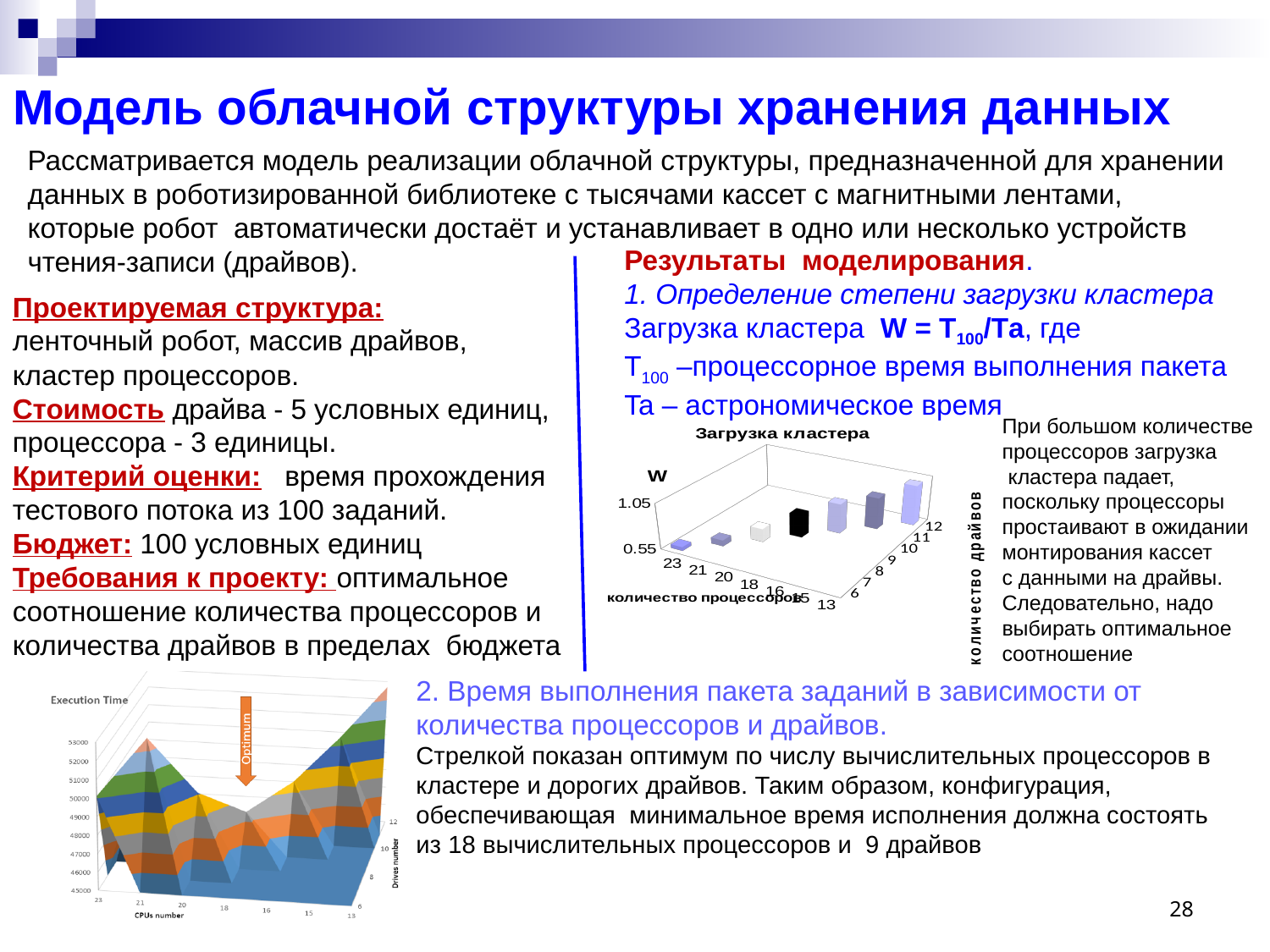
In the 'Загрузка кластера' chart, is the value for 23 processors greater or less than 1.05? less In the 'Загрузка кластера' chart, is the bar for 13 processors taller or shorter than the bar for 23 processors? taller In the 'Загрузка кластера' chart, what kind of chart is shown? bar chart In the 'Загрузка кластера' chart, as the number of processors decreases from 23 to 13 along the x axis, does W rise or fall? rise In the 'Execution Time' chart, what is the highest tick value on the vertical axis? 53000 In the 'Загрузка кластера' chart, how many bars are plotted? 7 In the 'Загрузка кластера' chart, what is the label of the depth axis? количество драйвов What is the title of the chart in the bottom-left of the slide? Execution Time In the 'Загрузка кластера' chart, which number of processors has the highest bar? 13 In the 'Загрузка кластера' chart, which number of processors has the lowest bar? 23 In the 'Execution Time' chart, how many CPU-number ticks are shown on the horizontal axis? 7 What is the title of the chart in the middle-right of the slide? Загрузка кластера